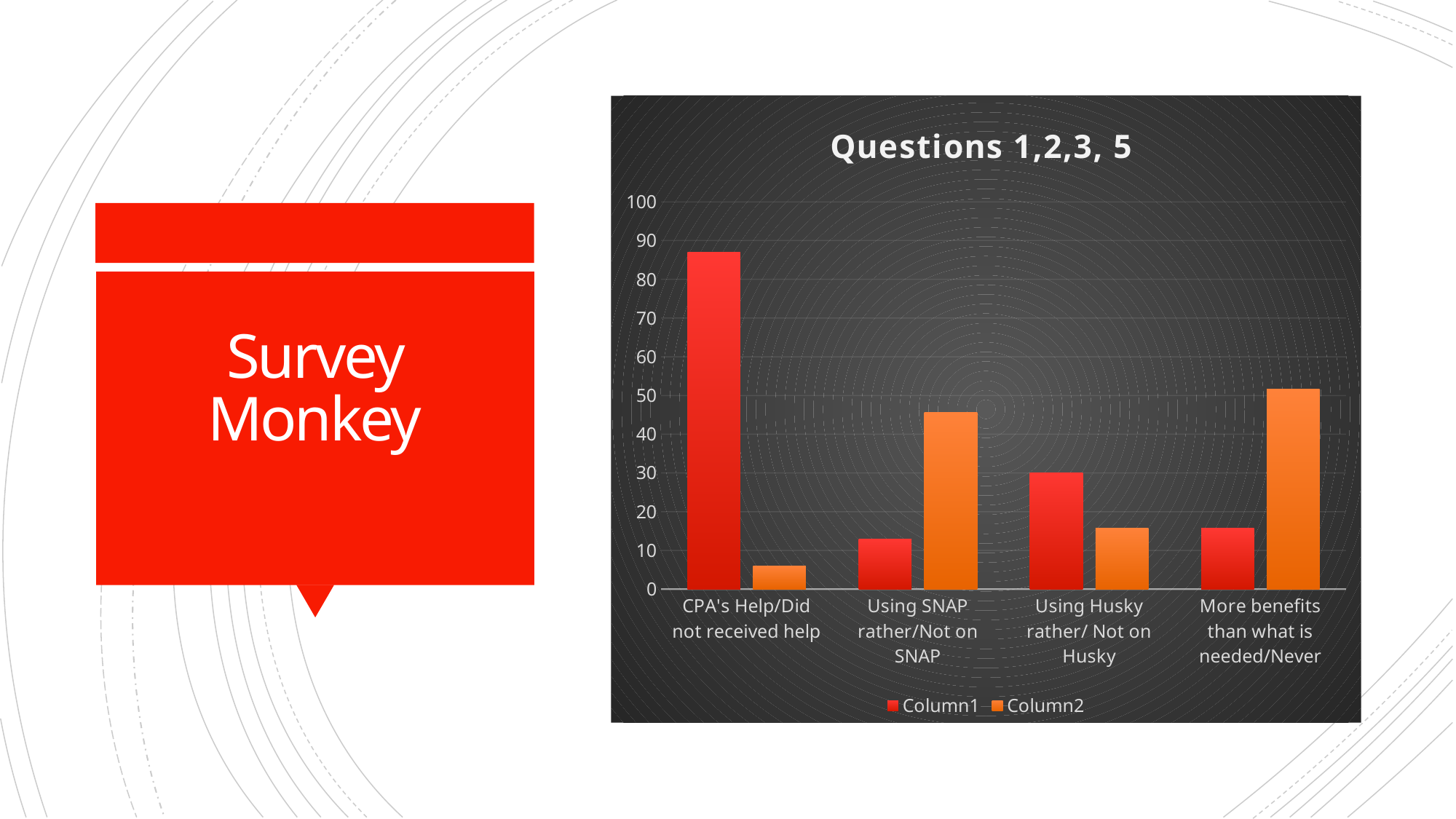
What is the title of the chart? Questions 1,2,3, 5 How many categories are shown on the x axis? 4 Is the Column2 value for Using SNAP rather/Not on SNAP greater or less than 40? greater Which category has the highest Column2 value? More benefits than what is needed/Never Which category has the highest Column1 value? CPA's Help/Did not received help How many series does the legend list? 2 Is the Column1 value for CPA's Help/Did not received help greater or less than 80? greater What type of chart is shown on the slide? bar chart Which category has the lowest Column2 value? CPA's Help/Did not received help For Using Husky rather/ Not on Husky, which series has the larger value, Column1 or Column2? Column1 For Using SNAP rather/Not on SNAP, which series has the larger value, Column1 or Column2? Column2 Is the Column2 value for CPA's Help/Did not received help greater or less than 10? less